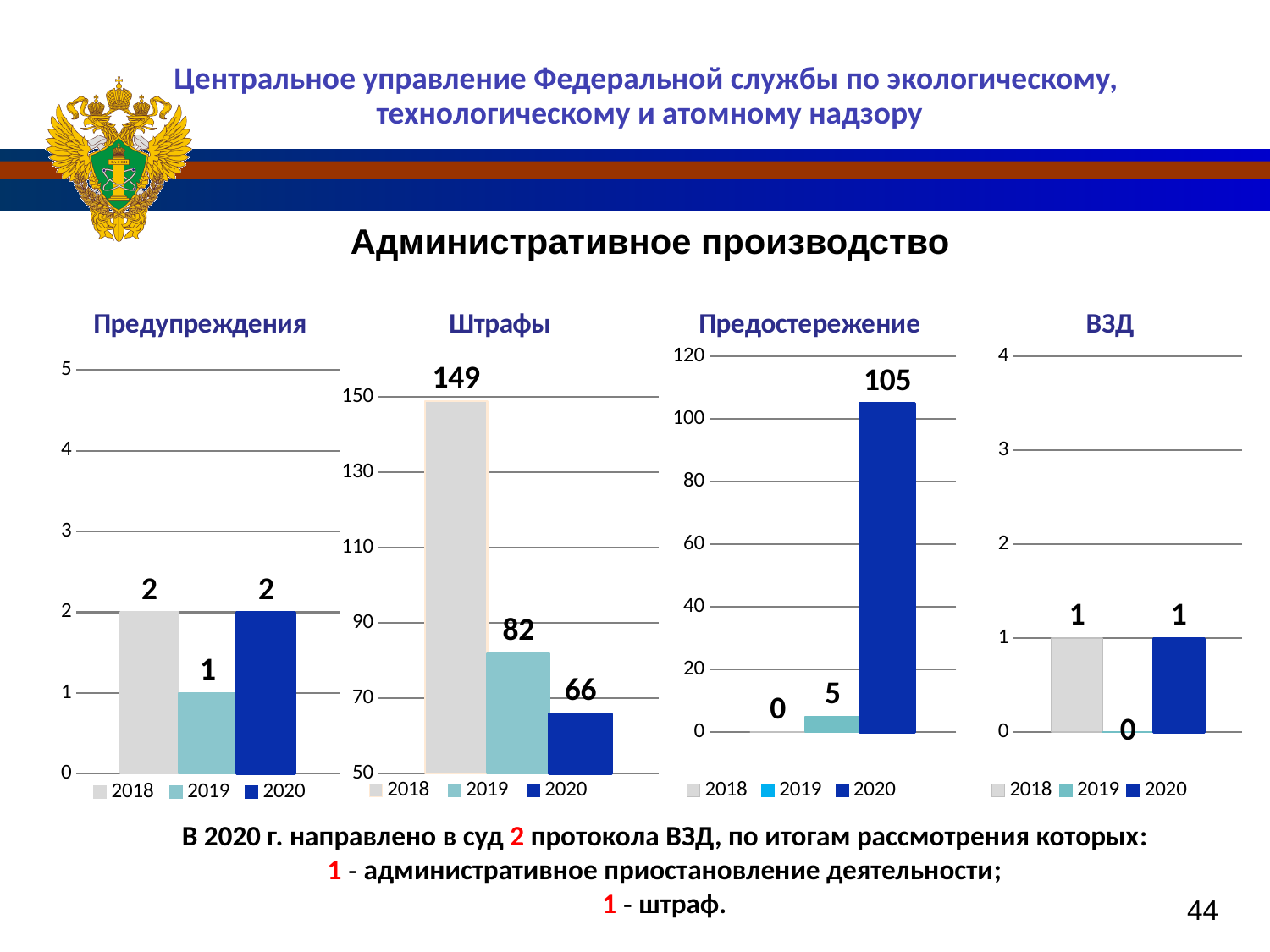
In the 'Предостережение' chart, what is the value for 2020? 105 In the 'Предостережение' chart, which year has the highest value? 2020 What kind of chart is the 'ВЗД' chart? bar chart In the 'Штрафы' chart, which year has the lowest value? 2020 In the 'Штрафы' chart, what is the value for 2018? 149 In the 'ВЗД' chart, what is the value for 2019? 0 In the 'Штрафы' chart, what is the difference between the values for 2018 and 2020? 83 In the 'Штрафы' chart, which is larger, the value for 2019 or the value for 2020? 2019 In the 'Штрафы' chart, do the values rise or fall from 2018 to 2020? fall In the 'Предупреждения' chart, what is the value for 2019? 1 How many series does the legend of the 'Предупреждения' chart list? 3 In the 'Предостережение' chart, what is the difference between the values for 2020 and 2019? 100